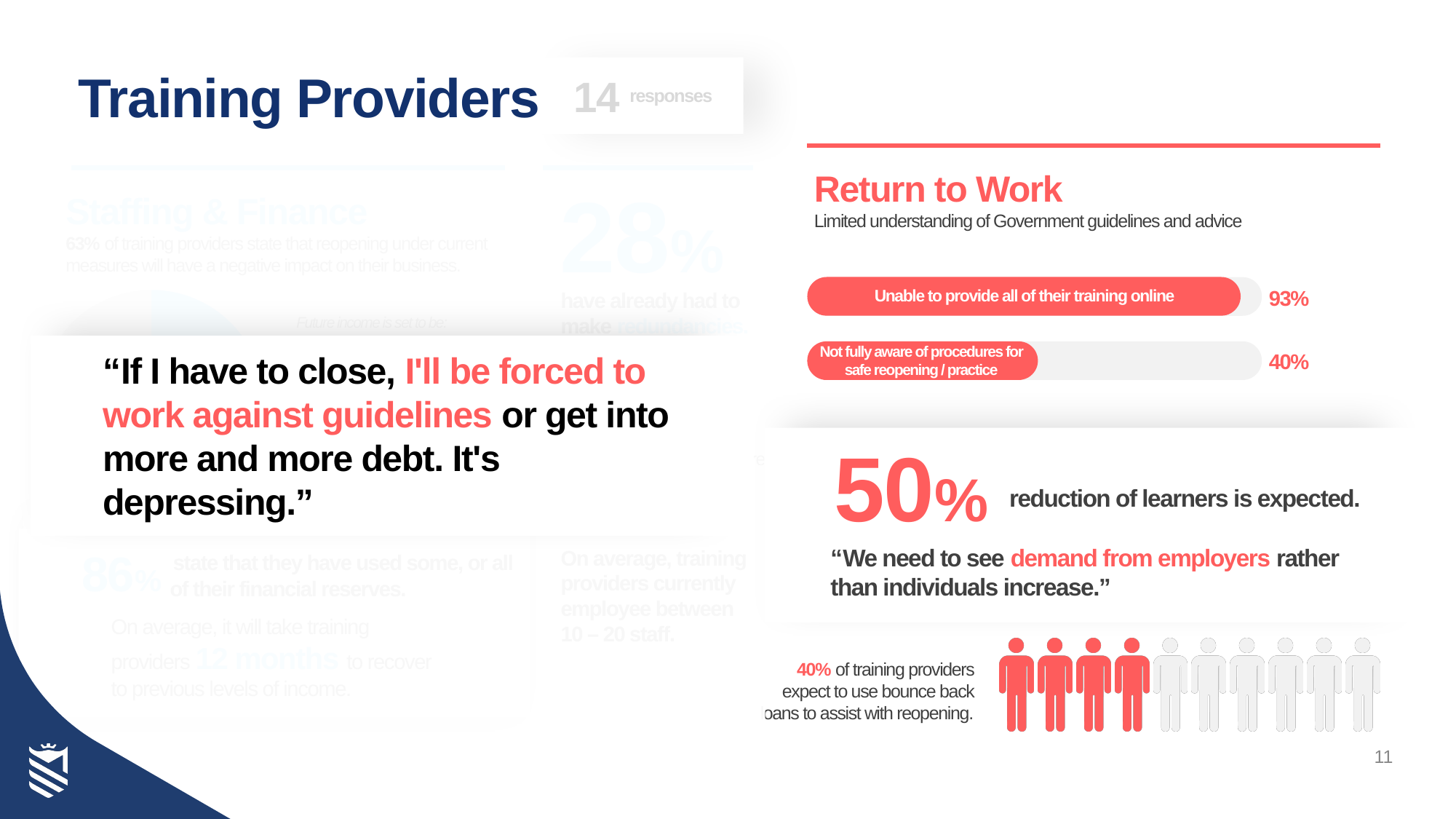
What kind of chart is shown under the Return to Work heading? Bar chart In the Return to Work chart, what percentage of training providers are unable to provide all of their training online? 93% What is the subtitle printed under the Return to Work heading? Limited understanding of Government guidelines and advice According to the pictogram at the bottom right, what percentage of training providers expect to use bounce back loans to assist with reopening? 40% In the Return to Work chart, which is larger: the value for being unable to provide all training online or the value for not being fully aware of safe reopening procedures? Unable to provide all of their training online In the Return to Work chart, which category has the lowest value? Not fully aware of procedures for safe reopening / practice How many bars does the Return to Work chart show? 2 In the Return to Work chart, what is the difference in percentage points between the two bars? 53 In the Return to Work chart, what percentage are not fully aware of procedures for safe reopening / practice? 40% In the Return to Work chart, which category has the highest value? Unable to provide all of their training online In the pictogram at the bottom right, how many person icons are shown in total? 10 In the pictogram at the bottom right, how many person icons are coloured red? 4